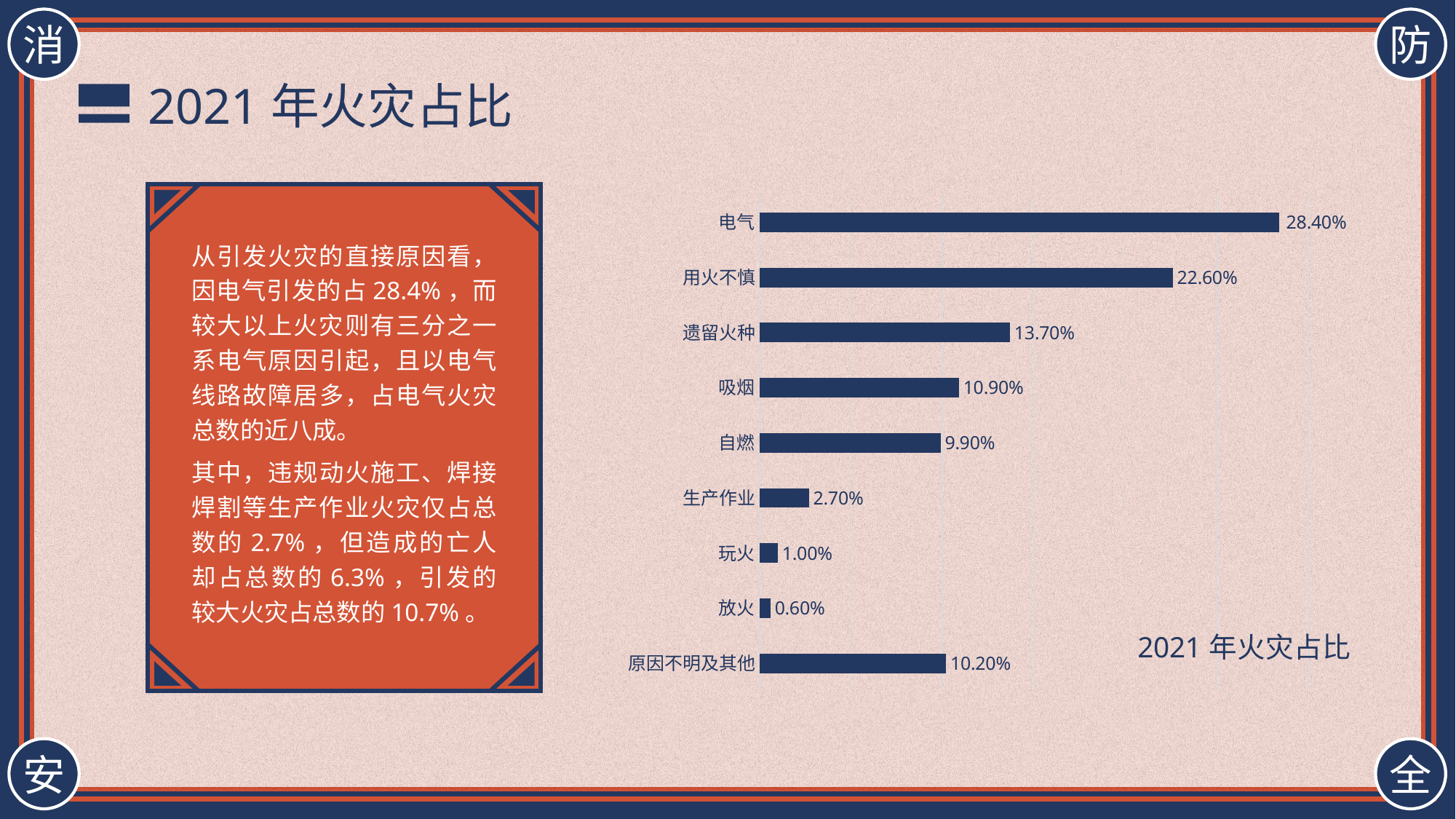
What kind of chart is shown on the slide? bar chart What is the value for 用火不慎? 22.60% How many categories are shown in the chart? 9 What is the value for 吸烟? 10.90% What is the value for 电气? 28.40% Which is larger, the value for 自燃 or the value for 原因不明及其他? 原因不明及其他 Which category has the highest value? 电气 Which category has the lowest value? 放火 What is the difference between the values for 电气 and 用火不慎? 5.80% What is the difference between the values for 遗留火种 and 吸烟? 2.80% What is the title of the chart? 2021 年火灾占比 What is the value for 原因不明及其他? 10.20%